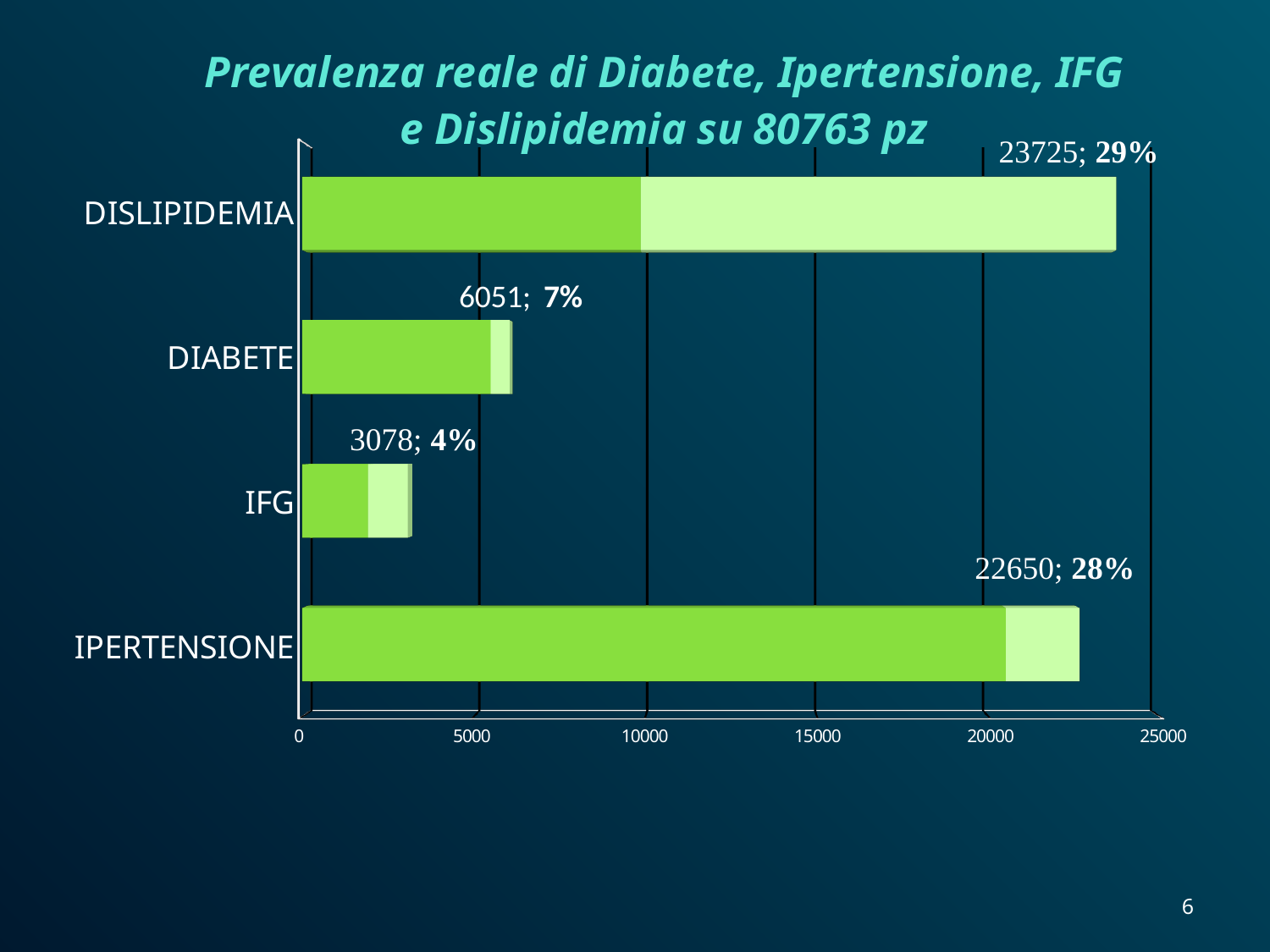
What kind of chart is shown on the slide? Bar chart What is the value shown for IPERTENSIONE? 22650; 28% What is the value shown for DISLIPIDEMIA? 23725; 29% How many categories are shown in the chart? 4 Is the value for IPERTENSIONE greater or less than 20000? greater What is the difference between the counts for DISLIPIDEMIA and IPERTENSIONE? 1075 What is the value shown for IFG? 3078; 4% Which is larger, the value for DIABETE or the value for IFG? DIABETE What is the value shown for DIABETE? 6051; 7% What is the difference between the counts for DIABETE and IFG? 2973 Which category has the lowest value? IFG Which category has the highest value? DISLIPIDEMIA